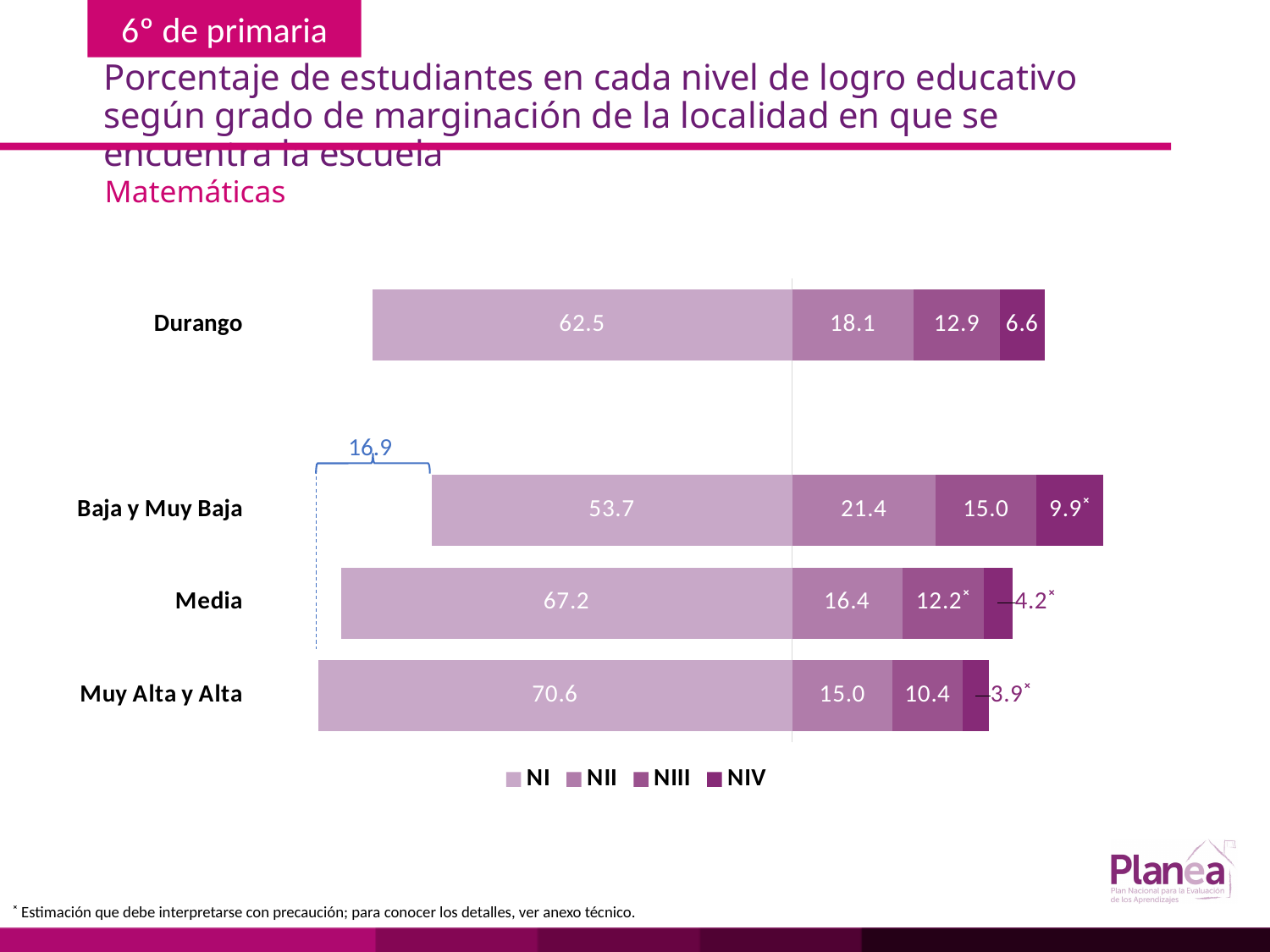
What is the difference between the NII values for Baja y Muy Baja and Media? 5.0 What is the NIII value for Durango? 12.9 What kind of chart is shown on the slide? Stacked bar chart Which category has the highest NI value? Muy Alta y Alta What is the NI value for Durango? 62.5 What is the NI value for Muy Alta y Alta? 70.6 How many categories are shown on the chart? 4 Which category has the lowest NI value? Baja y Muy Baja What is the difference between the NI values for Muy Alta y Alta and Durango? 8.1 Which is larger, the NIII value for Durango or for Muy Alta y Alta? Durango How many series does the legend list? 4 What is the NII value for Baja y Muy Baja? 21.4